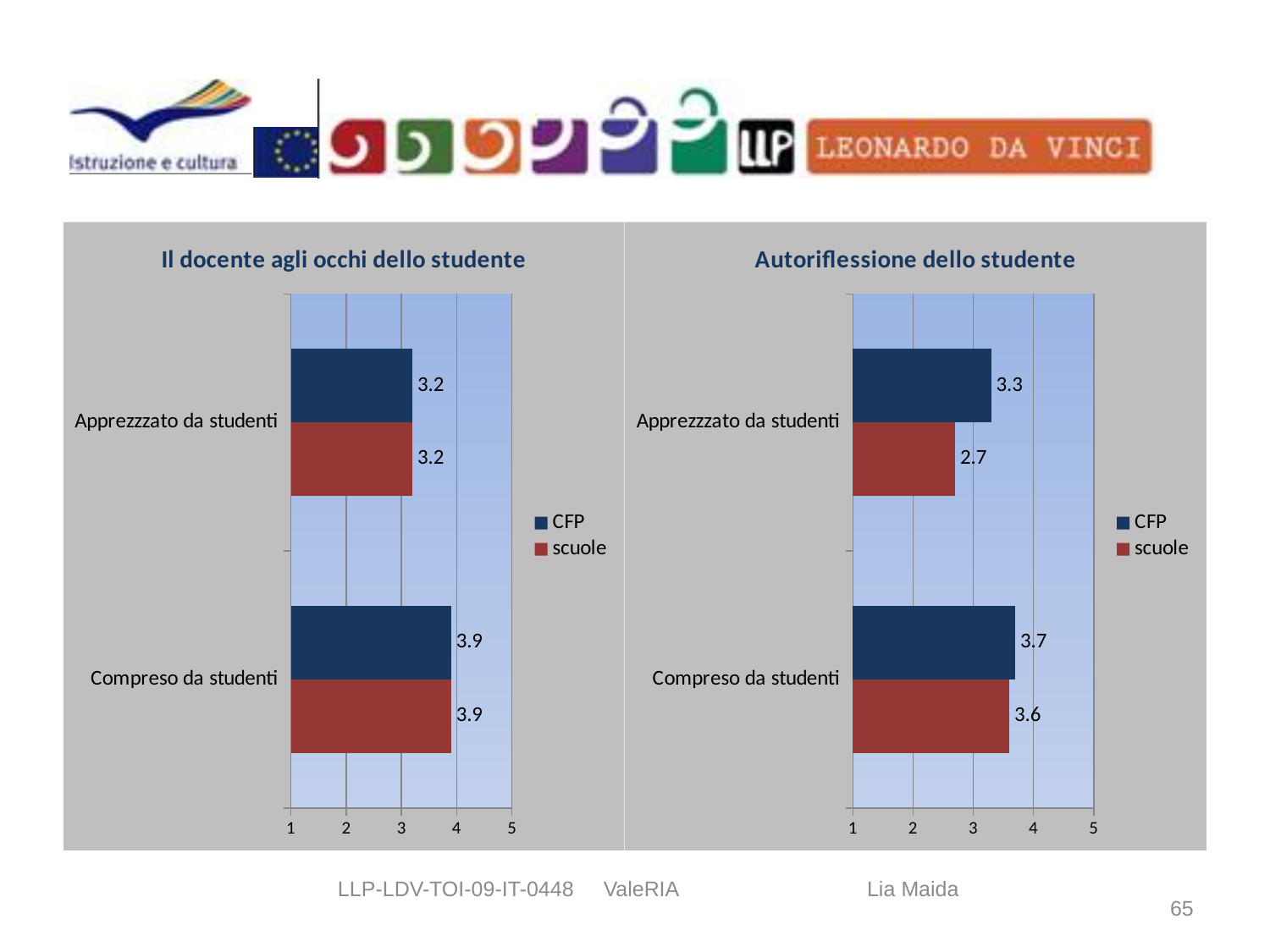
In the chart 'Autoriflessione dello studente', which series has the larger value for 'Compreso da studenti', CFP or scuole? CFP In the chart 'Il docente agli occhi dello studente', what is the CFP value for 'Compreso da studenti'? 3.9 In the chart 'Autoriflessione dello studente', what is the scuole value for 'Apprezzzato da studenti'? 2.7 In the chart 'Il docente agli occhi dello studente', which category has the highest CFP value? Compreso da studenti In the chart 'Il docente agli occhi dello studente', what is the scuole value for 'Apprezzzato da studenti'? 3.2 In the chart 'Autoriflessione dello studente', which category has the lowest scuole value? Apprezzzato da studenti What kind of chart is 'Il docente agli occhi dello studente'? Bar chart In the chart 'Autoriflessione dello studente', is the scuole value for 'Apprezzzato da studenti' greater or less than 3? less In the chart 'Autoriflessione dello studente', what is the difference between the CFP and scuole values for 'Apprezzzato da studenti'? 0.6 In the chart 'Autoriflessione dello studente', what is the CFP value for 'Compreso da studenti'? 3.7 How many categories are shown in the chart 'Autoriflessione dello studente'? 2 How many series does the legend list in the chart 'Il docente agli occhi dello studente'? 2